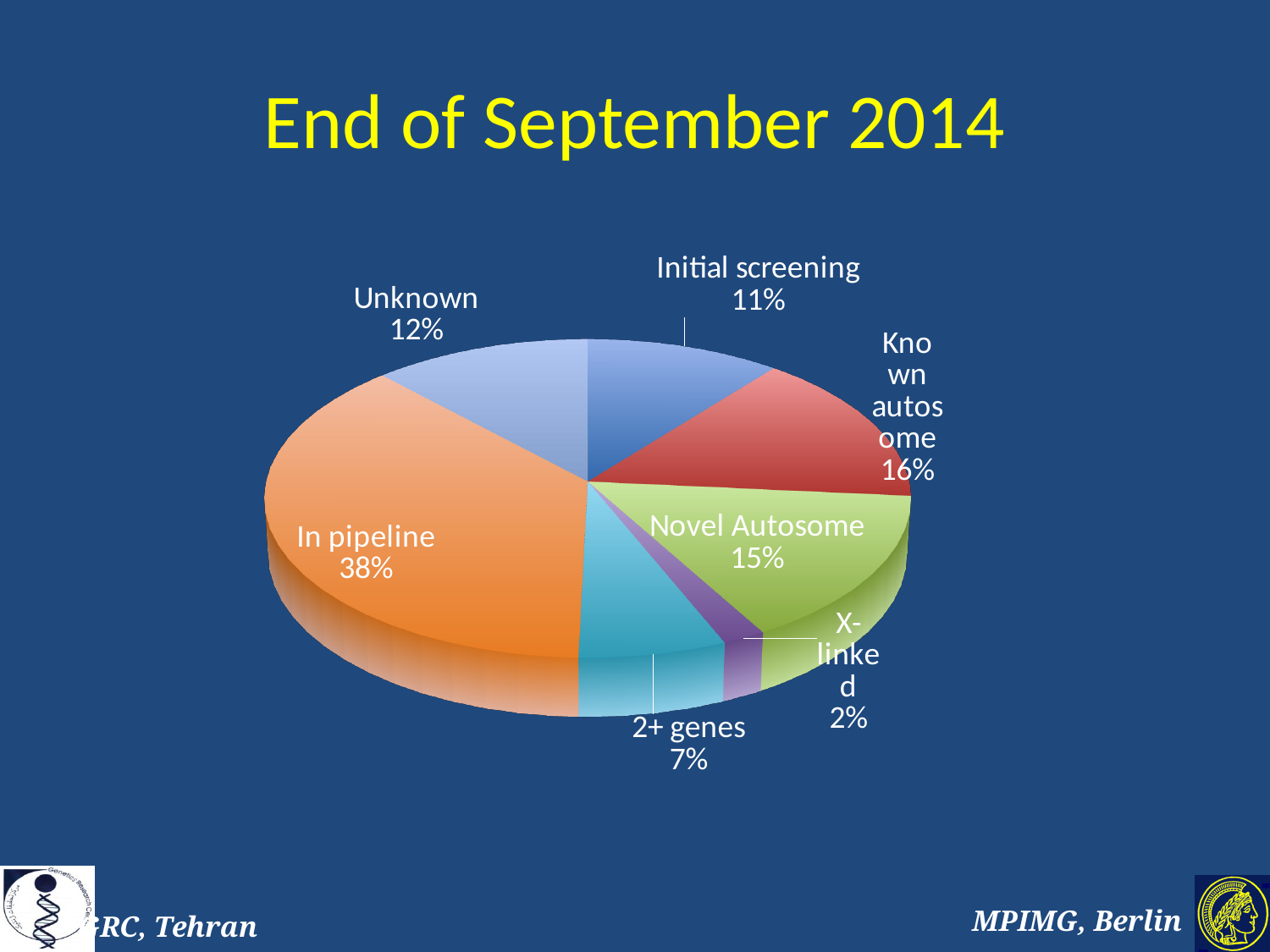
Which category has the largest slice of the pie? In pipeline What is the difference in percentage points between In pipeline and Unknown? 26 What share of the pie does In pipeline have? 38% What share of the pie does Novel Autosome have? 15% What is the title of the slide containing the pie chart? End of September 2014 Which is larger, the share for Initial screening or the share for 2+ genes? Initial screening Which category has the smallest slice of the pie? X-linked What share of the pie does X-linked have? 2% How many slices does the pie chart have? 7 What is the difference in percentage points between Known autosome and Novel Autosome? 1 What kind of chart is shown on the slide? pie chart